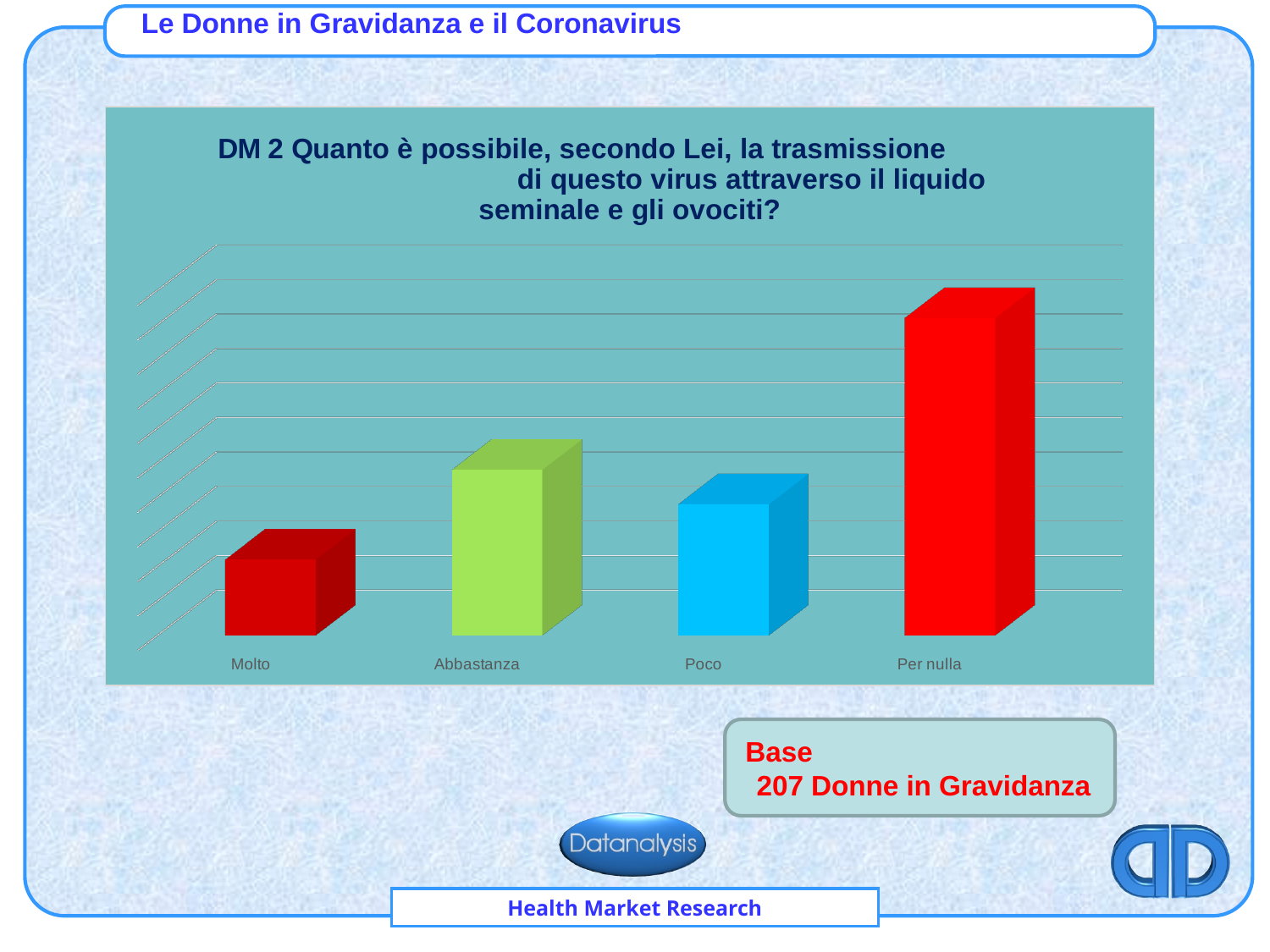
What is the label of the second category from the left on the x axis? Abbastanza Which bar is taller, Per nulla or Abbastanza? Per nulla Which bar is taller, Abbastanza or Poco? Abbastanza Which category has the lowest bar in the chart? Molto How many categories are shown on the x axis of the chart? 4 Which category has the highest bar in the chart? Per nulla Which bar is taller, Molto or Poco? Poco What kind of chart is shown on the slide? Bar chart What colour is the bar for Poco? Blue